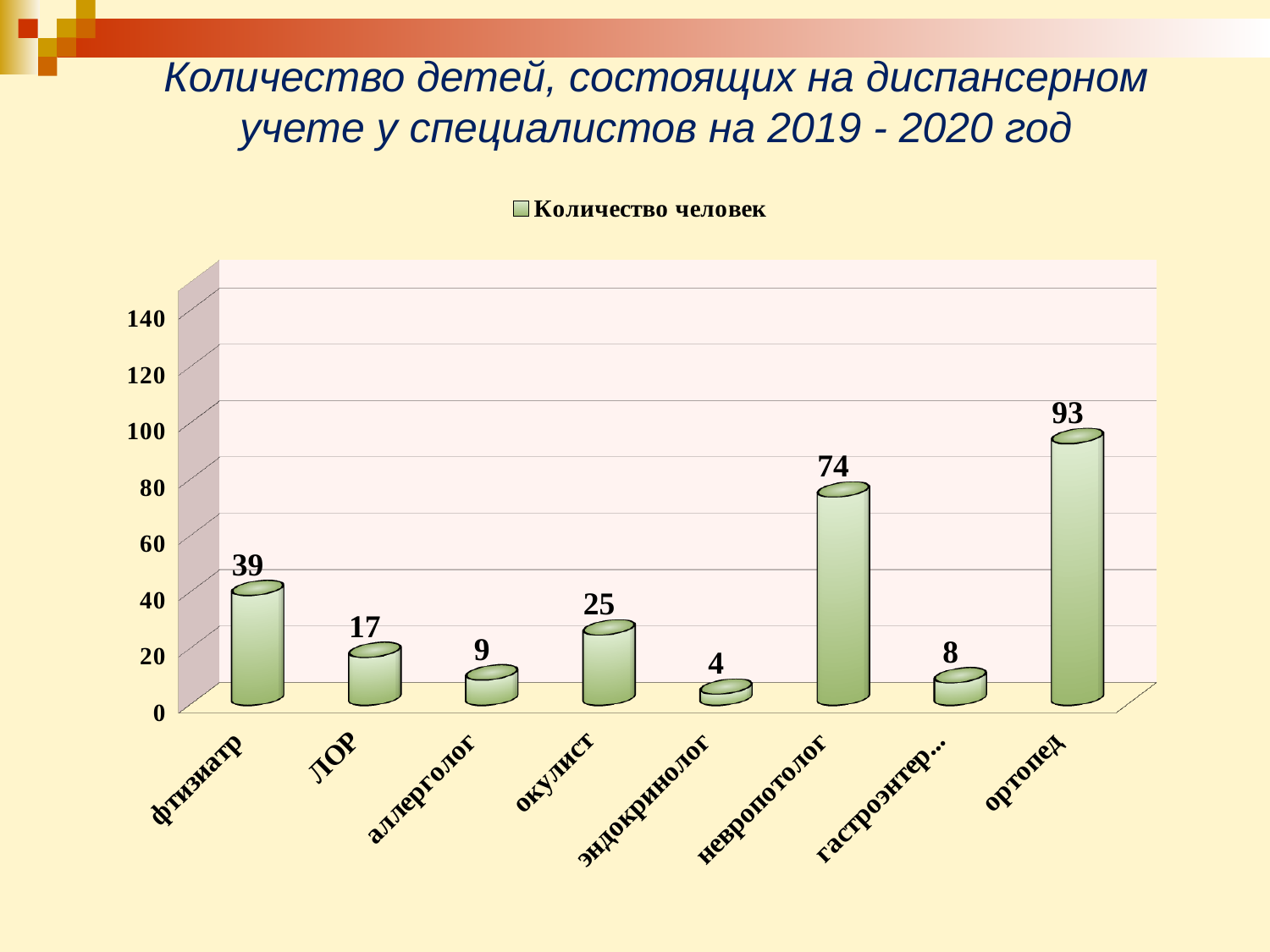
How many series does the legend list? 1 What is the value for эндокринолог? 4 Is the value for невропотолог greater or less than 60? greater What is the value for невропотолог? 74 What kind of chart is shown on the slide? bar chart Which category has the lowest value? эндокринолог What is the value for фтизиатр? 39 How many categories are shown on the x axis? 8 Which category has the highest value? ортопед What is the difference between the values for ортопед and невропотолог? 19 What is the value for ортопед? 93 Which is larger, the value for ЛОР or the value for окулист? окулист